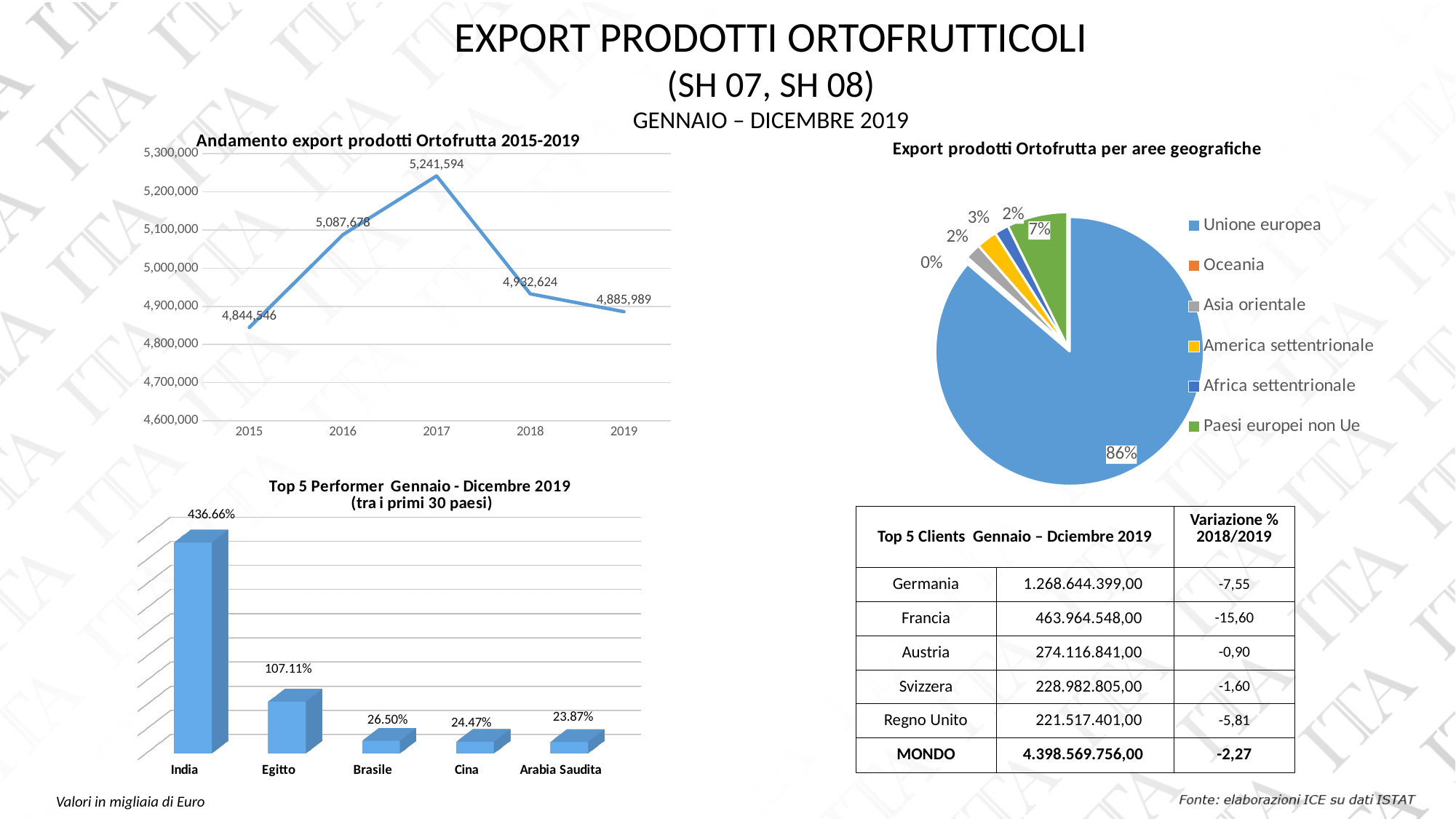
What kind of chart is 'Andamento export prodotti Ortofrutta 2015-2019'? line chart In the chart 'Andamento export prodotti Ortofrutta 2015-2019', which year has the lowest value? 2015 How many countries are shown in the chart 'Top 5 Performer Gennaio - Dicembre 2019'? 5 In the pie chart 'Export prodotti Ortofrutta per aree geografiche', what share does Unione europea have? 86% In the chart 'Andamento export prodotti Ortofrutta 2015-2019', what is the value for 2017? 5,241,594 In the chart 'Andamento export prodotti Ortofrutta 2015-2019', what is the difference between the 2017 value and the 2018 value? 308,970 How many entries does the legend of the pie chart 'Export prodotti Ortofrutta per aree geografiche' list? 6 In the chart 'Andamento export prodotti Ortofrutta 2015-2019', do the values rise or fall from 2017 to 2019? fall In the pie chart 'Export prodotti Ortofrutta per aree geografiche', what share does Paesi europei non Ue have? 7% In the chart 'Top 5 Performer Gennaio - Dicembre 2019', what is the value for Egitto? 107.11% In the chart 'Top 5 Performer Gennaio - Dicembre 2019', which country has the highest value? India In the chart 'Top 5 Performer Gennaio - Dicembre 2019', which is larger, the value for Brasile or the value for Arabia Saudita? Brasile